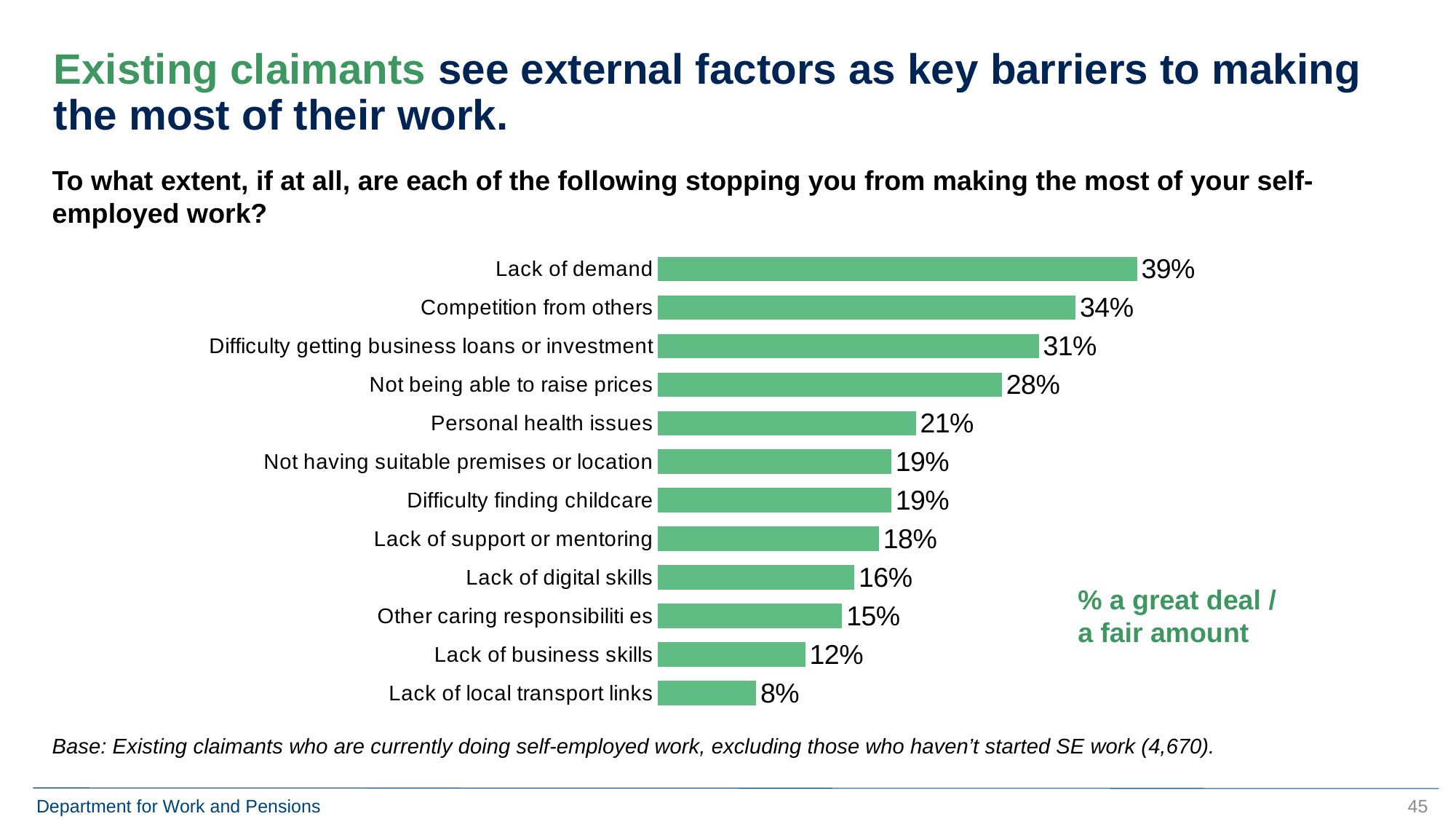
Which barrier has the lowest percentage? Lack of local transport links How many barriers are listed in the chart? 12 What kind of chart is shown on the slide? Bar chart Which is larger: the value for 'Lack of digital skills' or the value for 'Other caring responsibilities'? Lack of digital skills What is the difference between the values for 'Lack of demand' and 'Competition from others'? 5 percentage points What is the value shown for 'Lack of business skills'? 12% Which barrier has the highest percentage? Lack of demand What is the value shown for 'Difficulty getting business loans or investment'? 31% What is the difference between the values for 'Not being able to raise prices' and 'Lack of local transport links'? 20 percentage points What does the green text next to the chart say the percentages represent? % a great deal / a fair amount What percentage of existing claimants say lack of demand stops them a great deal or a fair amount? 39% What is the value shown for 'Personal health issues'? 21%